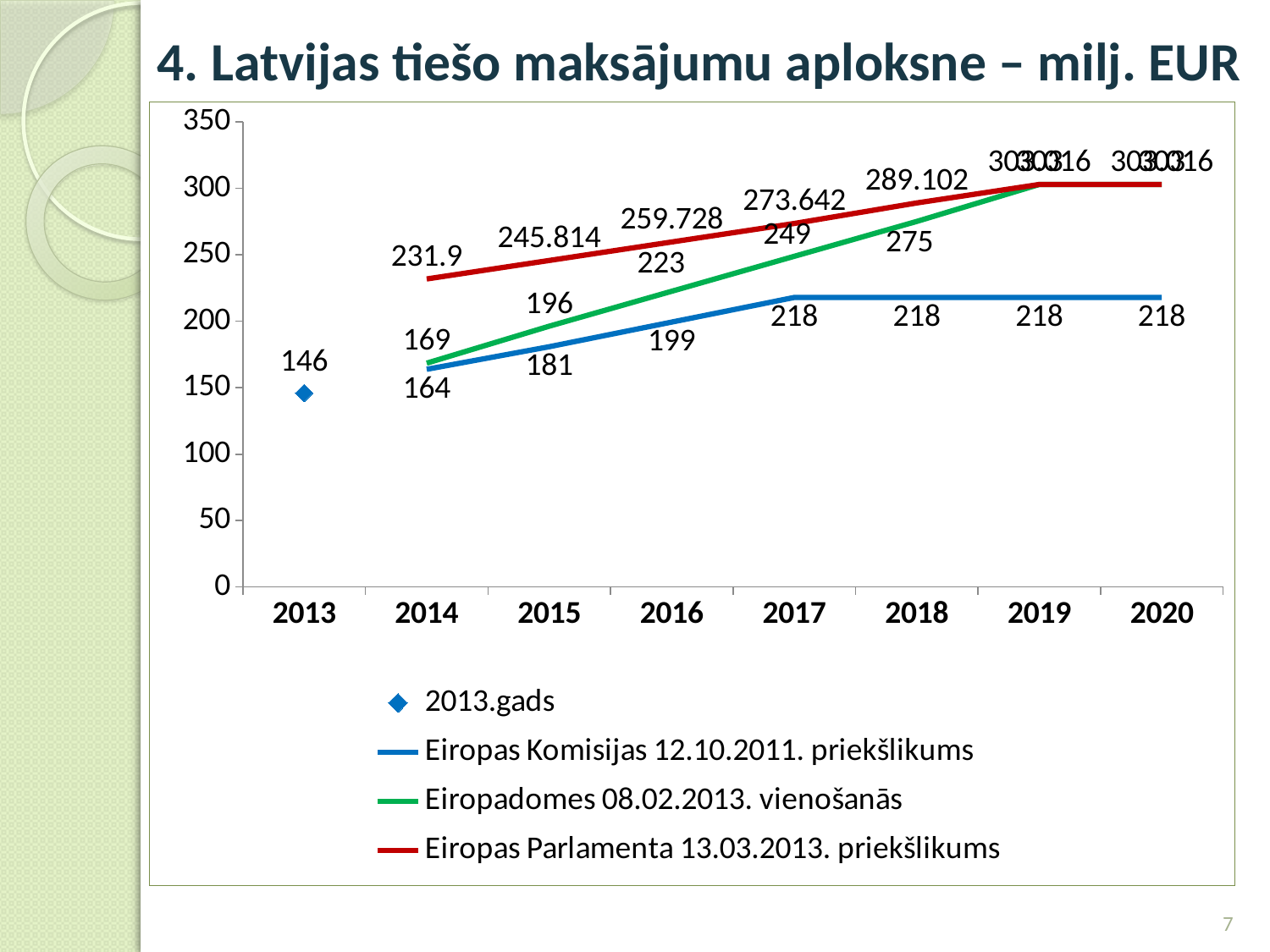
What kind of chart is shown on the slide? line chart What is the value for Eiropas Parlamenta 13.03.2013. priekšlikums in 2014? 231.9 In 2016, which is larger: Eiropadomes 08.02.2013. vienošanās or Eiropas Komisijas 12.10.2011. priekšlikums? Eiropadomes 08.02.2013. vienošanās What is the value for Eiropas Parlamenta 13.03.2013. priekšlikums in 2018? 289.102 Is the value for Eiropadomes 08.02.2013. vienošanās in 2019 greater or less than 250? greater What is the value of the 2013.gads point in 2013? 146 Which series has the highest value in 2014? Eiropas Parlamenta 13.03.2013. priekšlikums How many series does the legend list? 4 What is the value for Eiropadomes 08.02.2013. vienošanās in 2018? 275 How many years are shown on the x axis? 8 What is the value for Eiropas Komisijas 12.10.2011. priekšlikums in 2014? 164 What is the difference between the Eiropas Parlamenta 13.03.2013. priekšlikums value and the Eiropas Komisijas 12.10.2011. priekšlikums value in 2014? 67.9